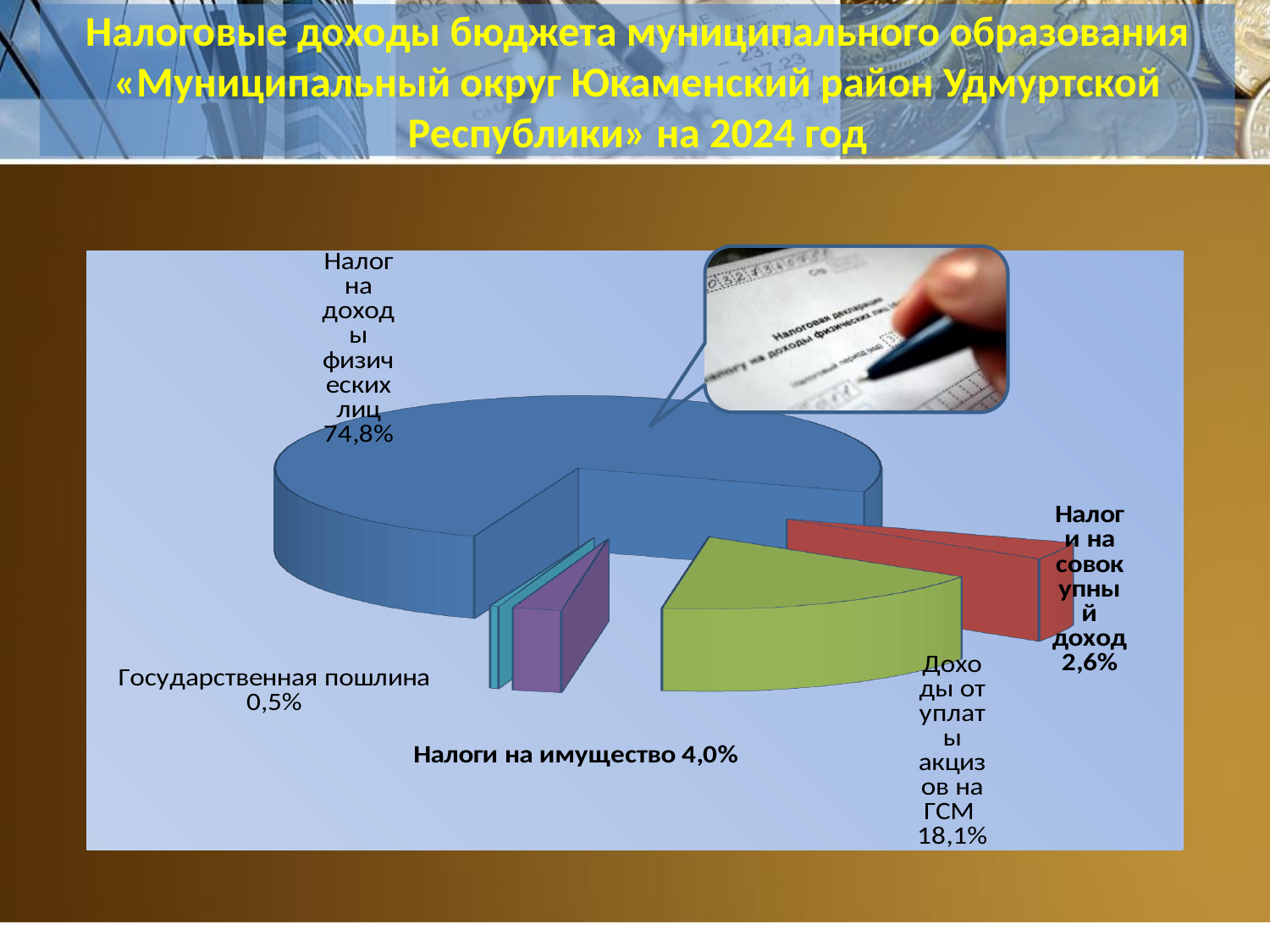
What is the value shown for "Налоги на совокупный доход"? 2,6% What is the value shown for "Государственная пошлина"? 0,5% Which category has the largest share of the pie? Налог на доходы физических лиц What is the value shown for "Налоги на имущество"? 4,0% How many categories are shown in the pie chart? 5 What kind of chart is shown on the slide? Pie chart Which category has the smallest share of the pie? Государственная пошлина What is the value shown for "Доходы от уплаты акцизов на ГСМ"? 18,1% Which is larger: the share of "Налоги на имущество" or "Налоги на совокупный доход"? Налоги на имущество What share of tax revenues does "Налог на доходы физических лиц" account for? 74,8% What year does the chart title refer to? 2024 What is the difference between the shares of "Налог на доходы физических лиц" and "Доходы от уплаты акцизов на ГСМ"? 56,7%